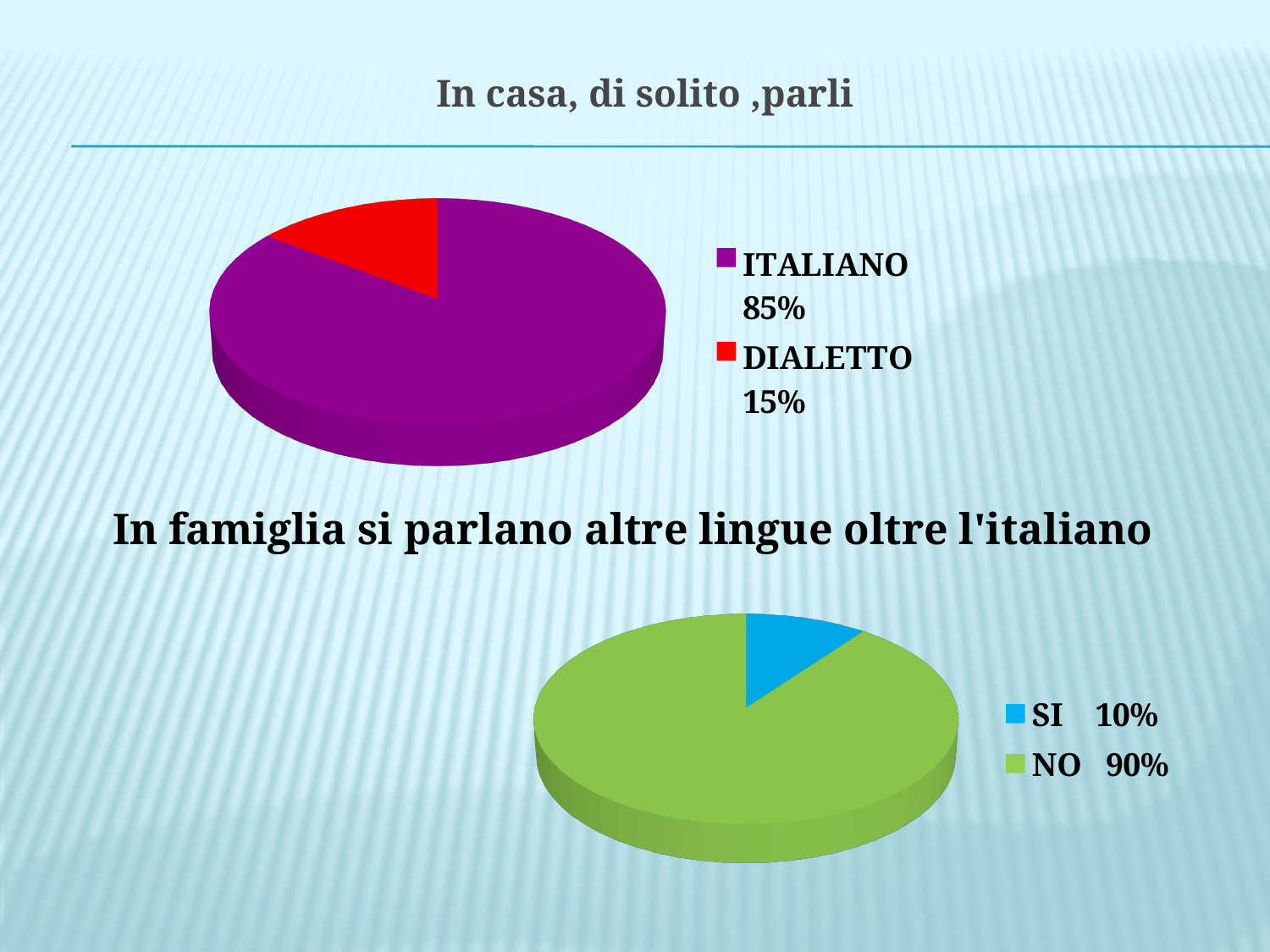
In the top pie chart ('In casa, di solito, parli'), what is the difference in percentage points between ITALIANO and DIALETTO? 70 percentage points In the bottom pie chart ('In famiglia si parlano altre lingue oltre l'italiano'), what is the difference in percentage points between NO and SI? 80 percentage points In the top pie chart ('In casa, di solito, parli'), which category has the largest slice? ITALIANO In the top pie chart ('In casa, di solito, parli'), how many slices are there? 2 In the top pie chart ('In casa, di solito, parli'), what share is DIALETTO? 15% In the top pie chart ('In casa, di solito, parli'), what share is ITALIANO? 85% In the bottom pie chart ('In famiglia si parlano altre lingue oltre l'italiano'), which is larger, SI or NO? NO In the bottom pie chart ('In famiglia si parlano altre lingue oltre l'italiano'), what share is SI? 10% What type of chart is the top chart on the slide? Pie chart In the bottom pie chart ('In famiglia si parlano altre lingue oltre l'italiano'), which category has the smallest slice? SI In the top pie chart ('In casa, di solito, parli'), what colour is the DIALETTO slice? Red